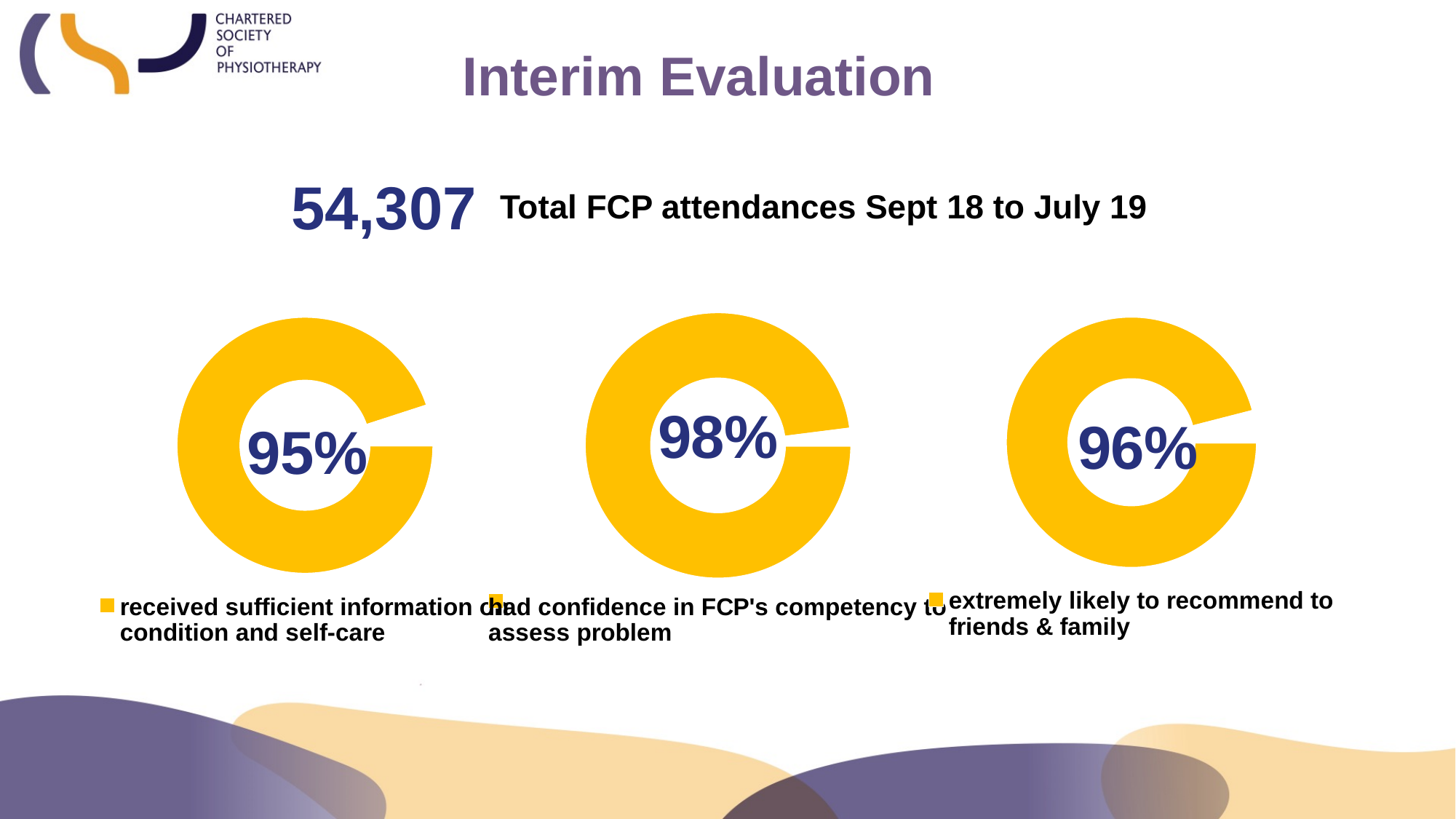
How many doughnut charts are shown on the slide? 3 What percentage is shown in the left doughnut chart (received sufficient information on condition and self-care)? 95% Which is larger: the percentage in the middle chart or the percentage in the right chart? The middle chart (98%) What is the difference between the percentage in the middle chart and the percentage in the left chart? 3% What is the difference between the percentage in the right chart and the percentage in the left chart? 1% Which of the three doughnut charts shows the lowest percentage? The left chart (received sufficient information on condition and self-care), 95% What type of chart is used to display the three percentages on the slide? Doughnut (pie) chart What colour is the filled portion of the doughnut charts? Yellow What percentage is shown in the middle doughnut chart (had confidence in FCP's competency to assess problem)? 98% Which of the three doughnut charts shows the highest percentage? The middle chart (had confidence in FCP's competency to assess problem), 98% What percentage is shown in the right doughnut chart (extremely likely to recommend to friends & family)? 96% What is the legend entry for the right doughnut chart? extremely likely to recommend to friends & family